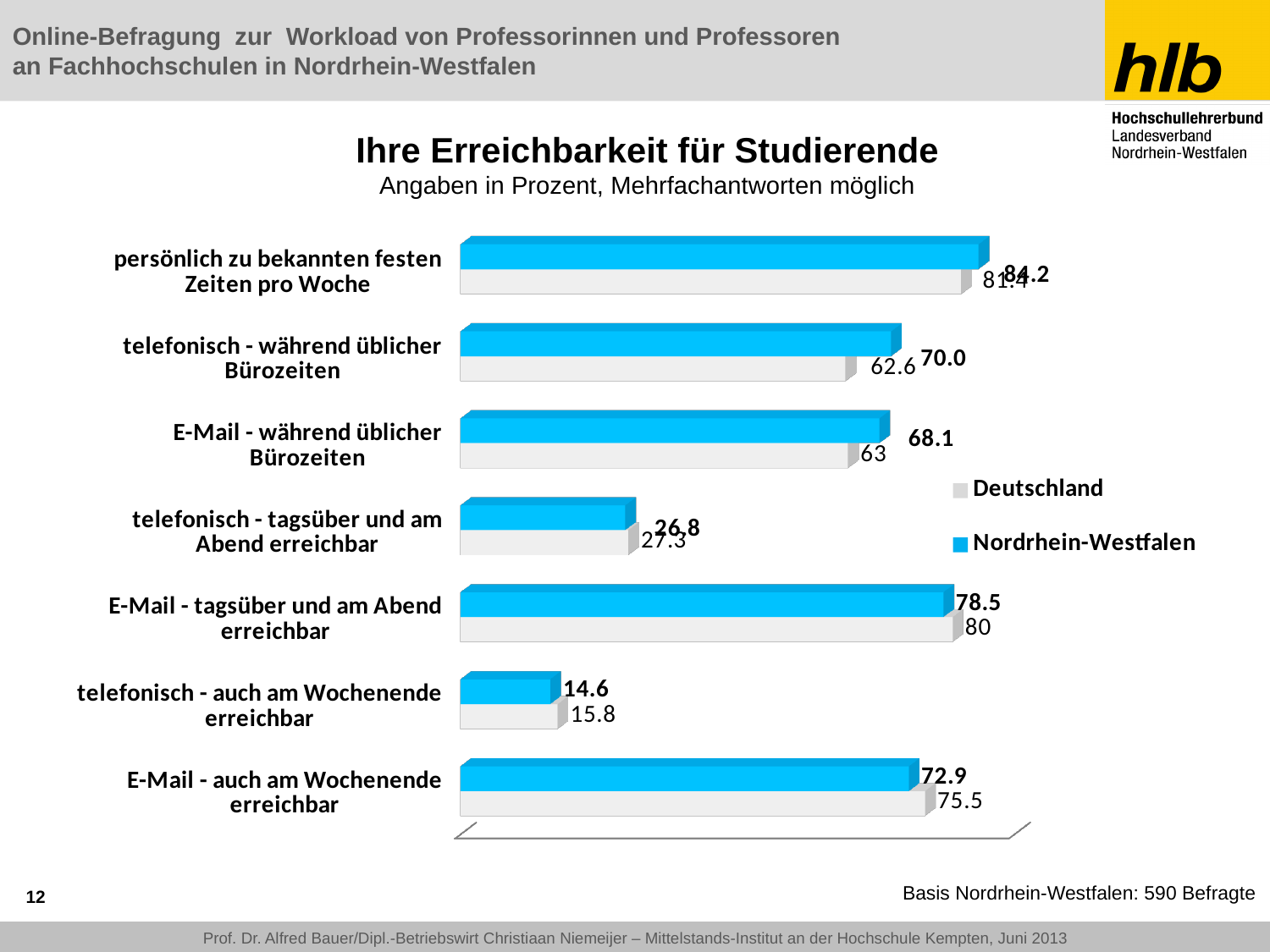
What kind of chart is shown on the slide? bar chart How many categories are shown in the chart? 7 What is the Nordrhein-Westfalen value for 'telefonisch - während üblicher Bürozeiten'? 70.0 Which category has the highest Nordrhein-Westfalen value? persönlich zu bekannten festen Zeiten pro Woche What is the Deutschland value for 'E-Mail - während üblicher Bürozeiten'? 63 How many series does the legend list? 2 What is the Deutschland value for 'E-Mail - auch am Wochenende erreichbar'? 75.5 Which category has the lowest Nordrhein-Westfalen value? telefonisch - auch am Wochenende erreichbar For 'E-Mail - tagsüber und am Abend erreichbar', which is larger: the Deutschland value or the Nordrhein-Westfalen value? Deutschland What is the Nordrhein-Westfalen value for 'telefonisch - auch am Wochenende erreichbar'? 14.6 Which series is shown in blue in the legend? Nordrhein-Westfalen What is the difference between the Nordrhein-Westfalen and Deutschland values for 'telefonisch - während üblicher Bürozeiten'? 7.4